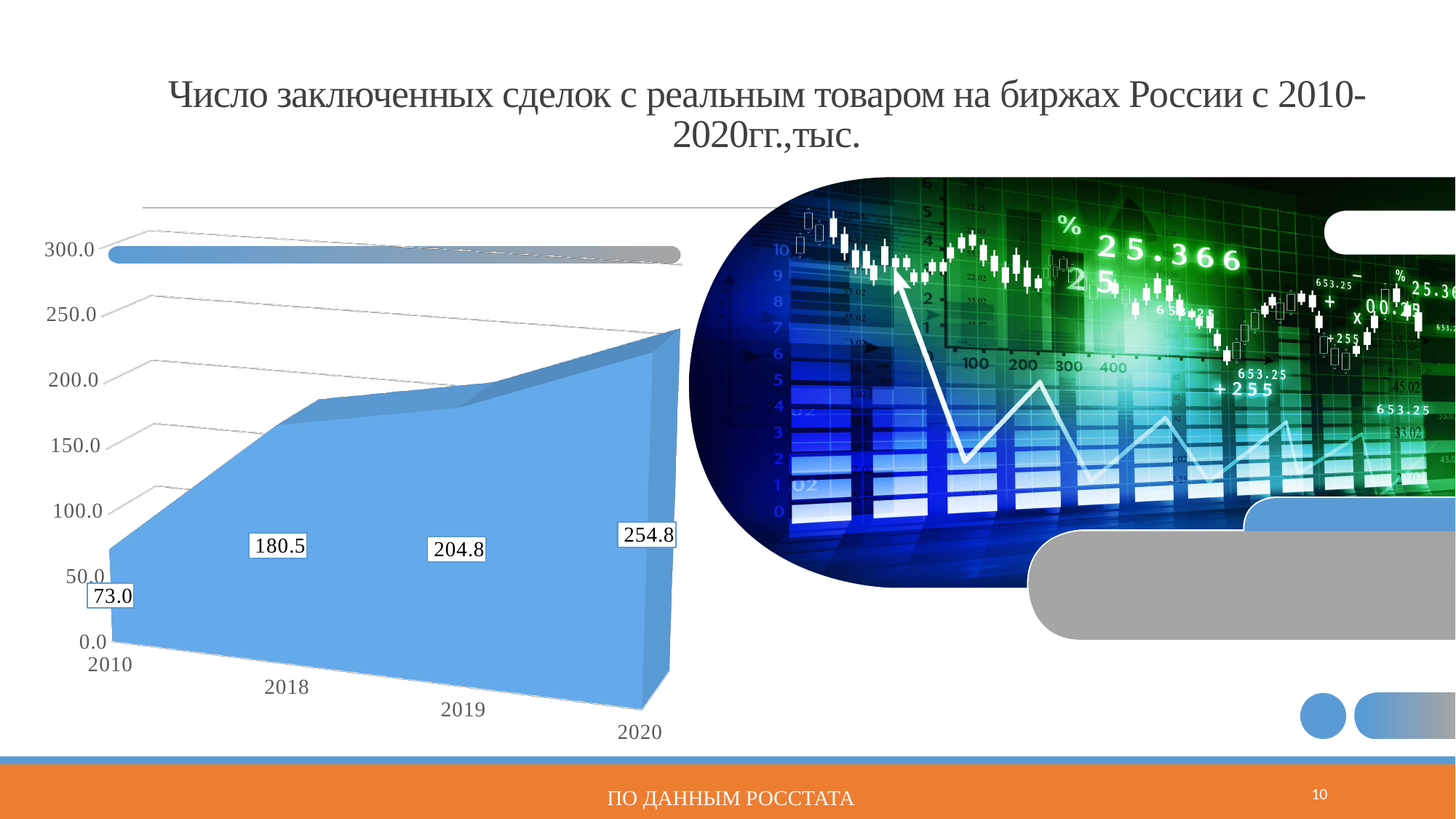
Do the values rise or fall from 2010 to 2020? rise What is the value for 2018? 180.5 Which year has the highest value? 2020 Which year has the lowest value? 2010 What is the value for 2020? 254.8 What is the value for 2019? 204.8 What is the difference between the values for 2018 and 2010? 107.5 How many years are plotted on the chart? 4 What is the difference between the values for 2020 and 2019? 50.0 What is the value for 2010? 73.0 Which is larger, the value for 2018 or the value for 2019? 2019 What kind of chart is shown on the slide? area chart